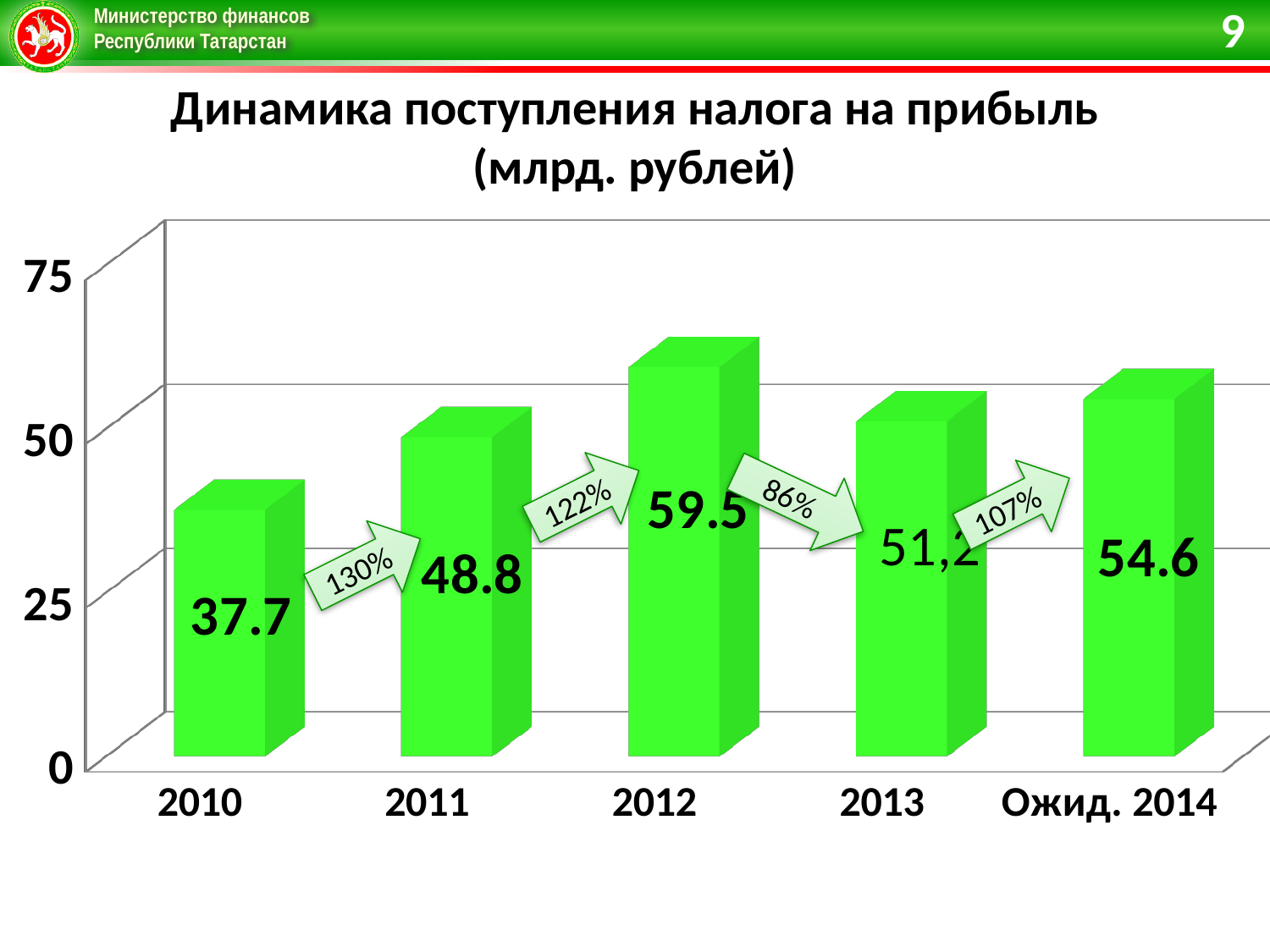
Is the value for 2013 greater or less than 50? greater Which year has the highest value? 2012 Which year has the lowest value? 2010 What percentage is shown on the arrow between 2010 and 2011? 130% What is the value for 2011? 48.8 Which is larger, the value for 2011 or the value for Ожид. 2014? Ожид. 2014 What is the value for 2012? 59.5 How many categories are shown on the x axis? 5 What is the value for Ожид. 2014? 54.6 What kind of chart is shown on the slide? bar chart What is the difference between the values for 2012 and 2010? 21.8 What is the value for 2010? 37.7